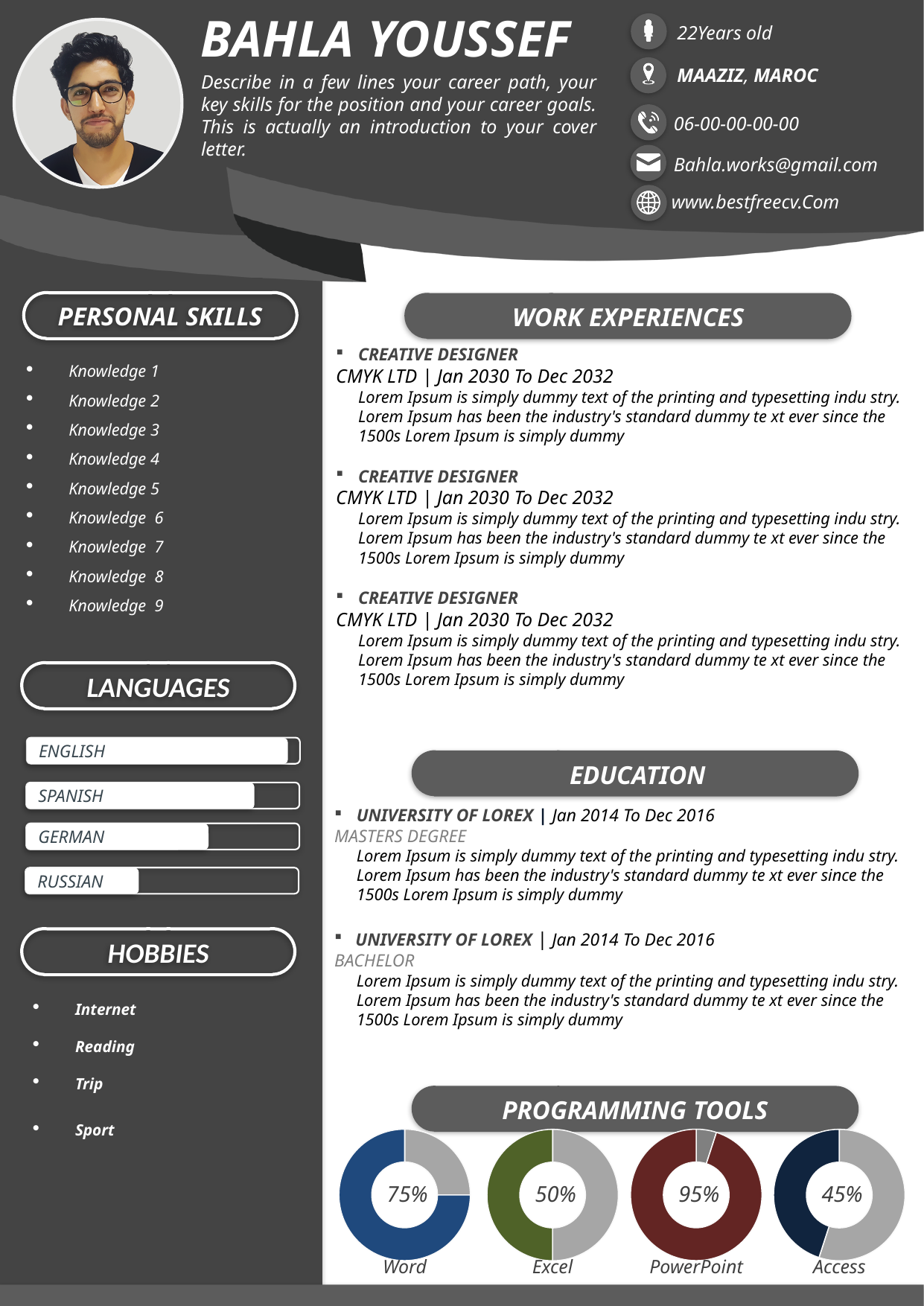
Among the Programming Tools donut charts, which tool has the highest percentage? PowerPoint In the Programming Tools section, which has a higher percentage, Word or Excel? Word What kind of chart is used to show the Programming Tools percentages? Donut chart In the Programming Tools section, what percentage is shown for Excel? 50% What colour is the filled portion of the Excel donut chart in the Programming Tools section? Green In the Programming Tools section, what percentage is shown for PowerPoint? 95% In the Programming Tools section, what percentage is shown for Access? 45% In the Programming Tools section, what is the difference between the Word and Excel percentages? 25% In the Programming Tools section, what percentage is shown for Word? 75% In the Programming Tools section, what is the difference between the PowerPoint and Access percentages? 50% How many donut charts are shown in the Programming Tools section? 4 Among the Programming Tools donut charts, which tool has the lowest percentage? Access